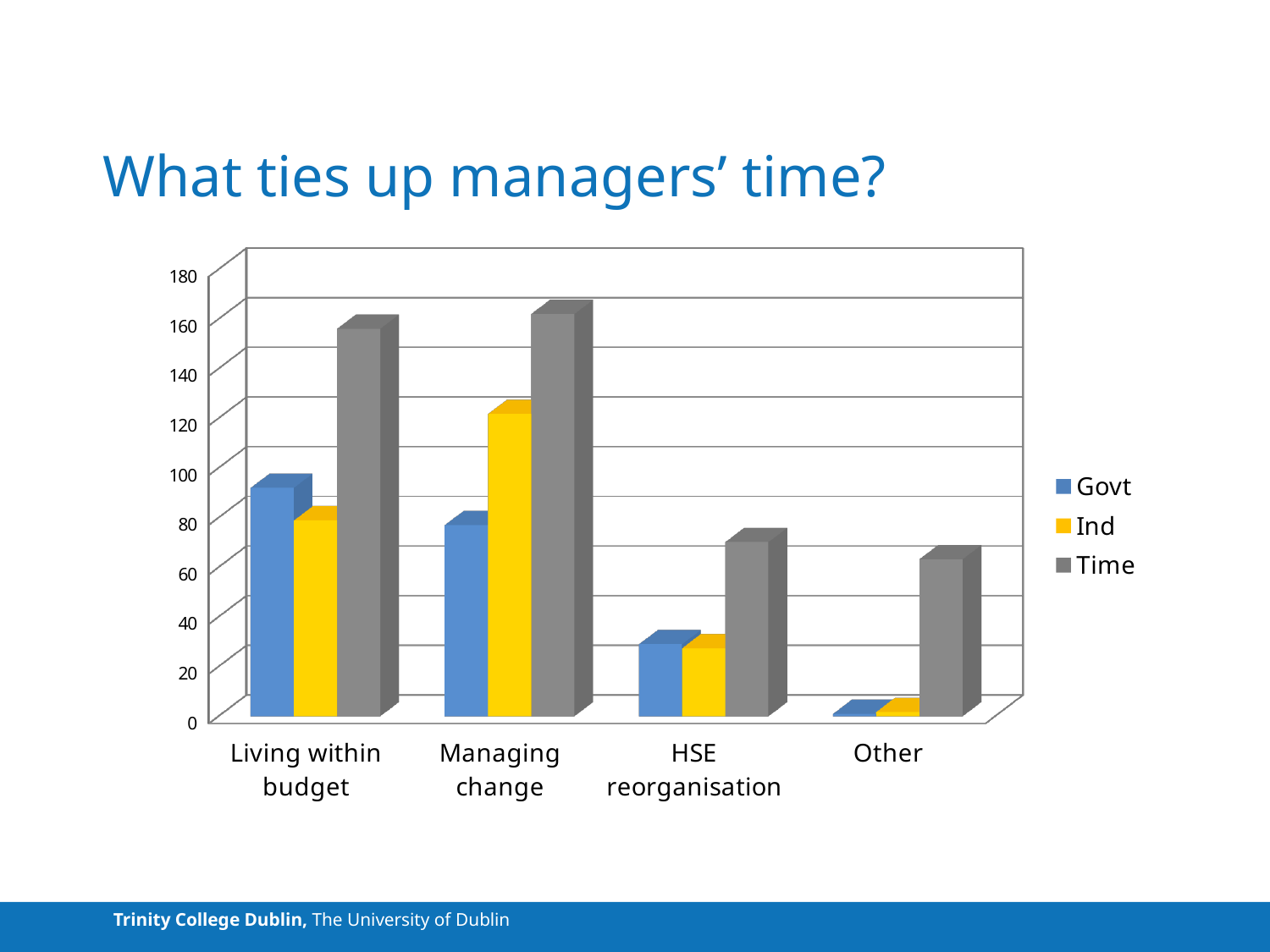
Is the Time value for Other greater or less than 40? greater What is the title of the slide containing the chart? What ties up managers' time? How many series does the chart's legend list? 3 Which series is shown in grey in the chart? Time Which category has the highest Ind value? Managing change For Managing change, which is larger, the Govt value or the Ind value? Ind Which category has the lowest Time value? Other Is the Time value for Living within budget greater or less than 140? greater How many categories are shown on the x axis of the chart? 4 Is the Govt value for HSE reorganisation greater or less than 40? less What kind of chart is shown on the slide? bar chart